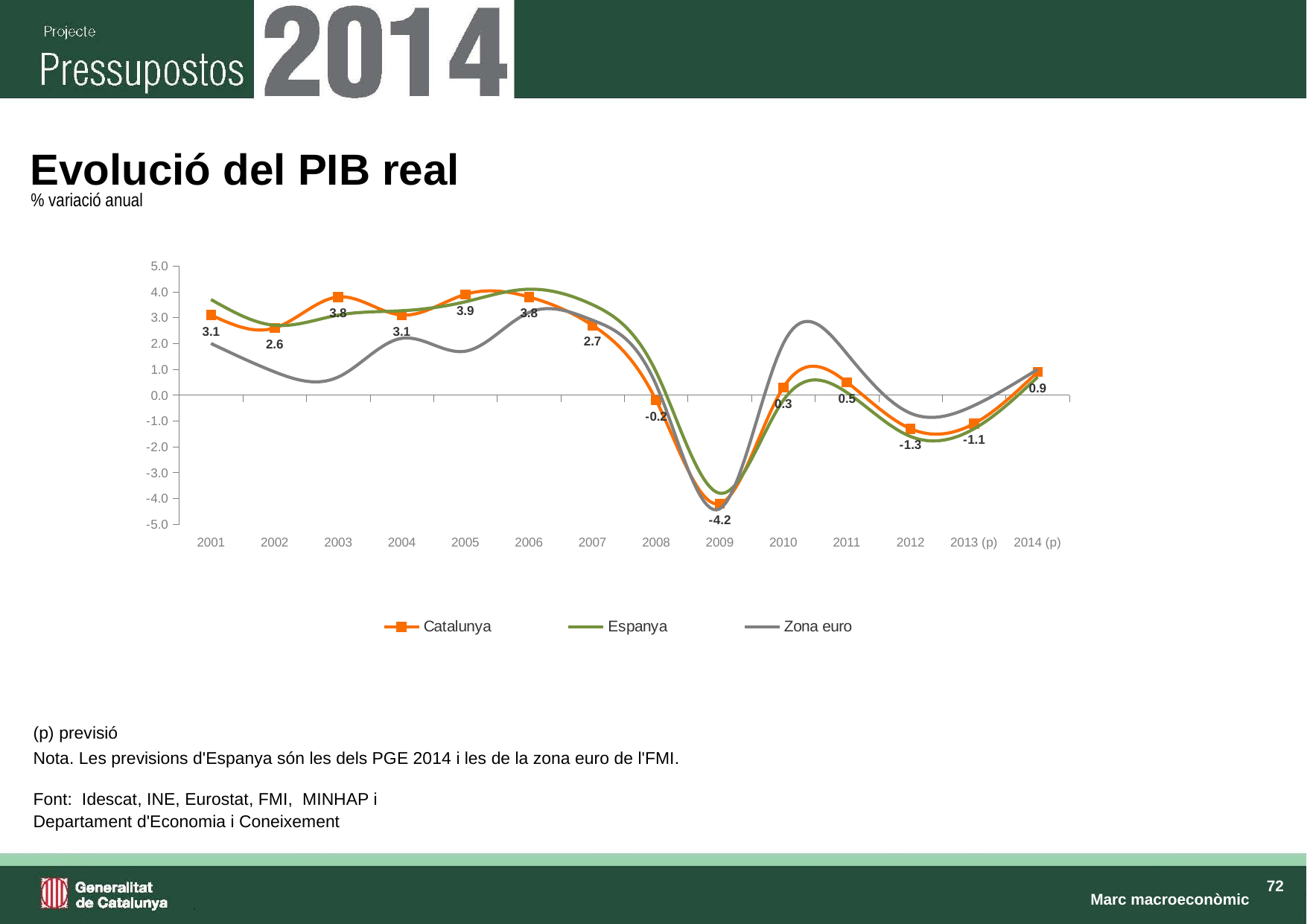
Which is larger for Catalunya, the value in 2010 or the value in 2011? 2011 What is the value for Catalunya in 2009? -4.2 Is the value for Zona euro in 2003 greater or less than 1.0? less What is the difference between the Catalunya values for 2013 (p) and 2014 (p)? 2.0 How many years are shown on the x axis? 14 What is the value for Catalunya in 2005? 3.9 What is the value for Catalunya in 2014 (p)? 0.9 What type of chart is shown on the slide? line chart In which year does the Catalunya series reach its lowest value? 2009 In which year does the Catalunya series reach its highest value? 2005 How many series does the legend list? 3 What is the title of the chart? Evolució del PIB real